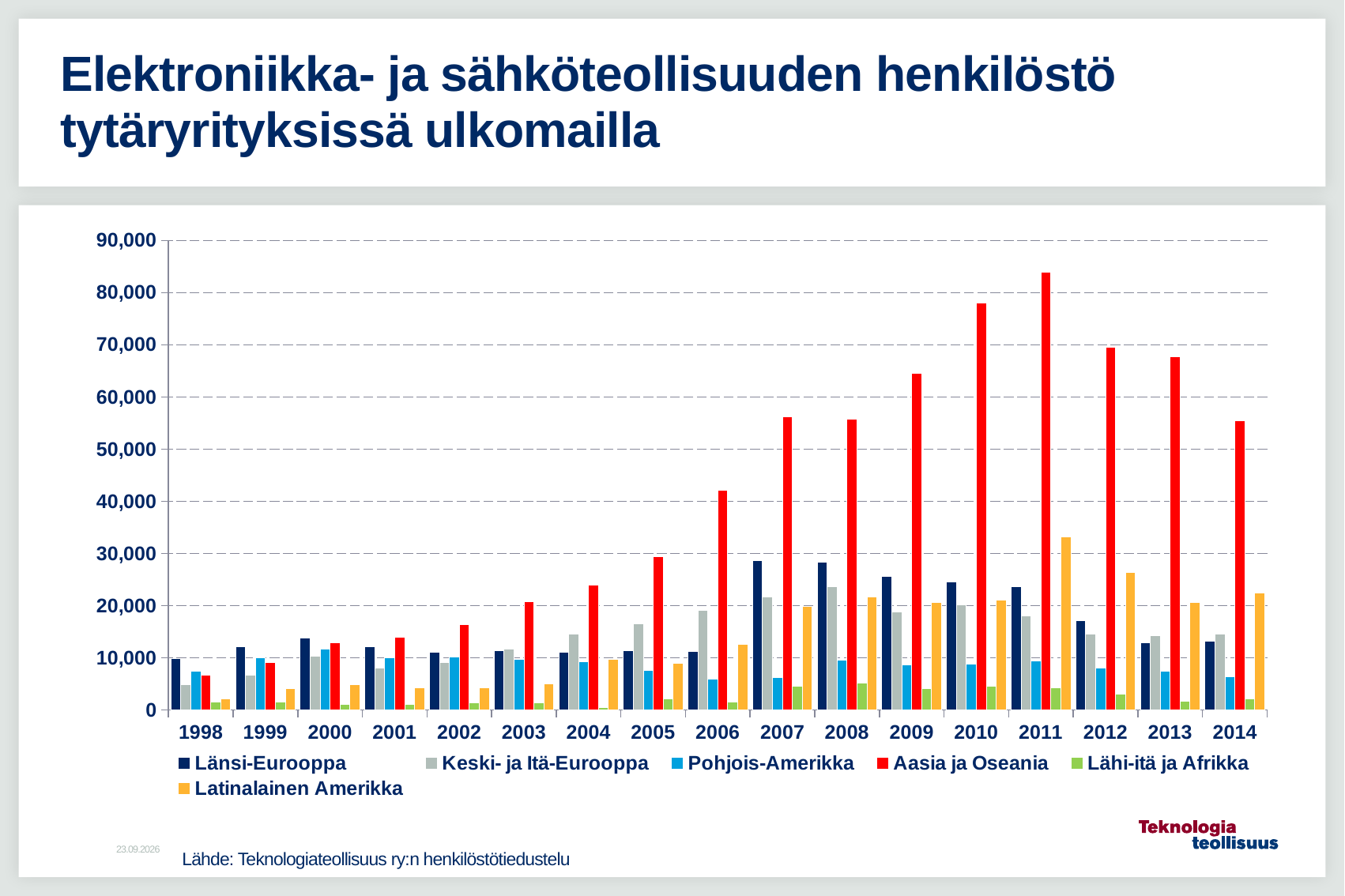
Is the value for Aasia ja Oseania in 2010 greater or less than 70,000? greater How many series does the legend list? 6 Is the value for Aasia ja Oseania in 2011 greater or less than 80,000? greater In which year is the value for Aasia ja Oseania lowest? 1998 Is the value for Pohjois-Amerikka in 2014 greater or less than 10,000? less How many years are shown on the x axis? 17 Does the value for Aasia ja Oseania rise or fall from 1998 to 2011? rise Which is larger, the value for Aasia ja Oseania in 2010 or in 2012? 2010 In which year is the value for Aasia ja Oseania highest? 2011 In which year is the value for Latinalainen Amerikka highest? 2011 What colour represents Aasia ja Oseania in the chart? red What kind of chart is shown on the slide? bar chart